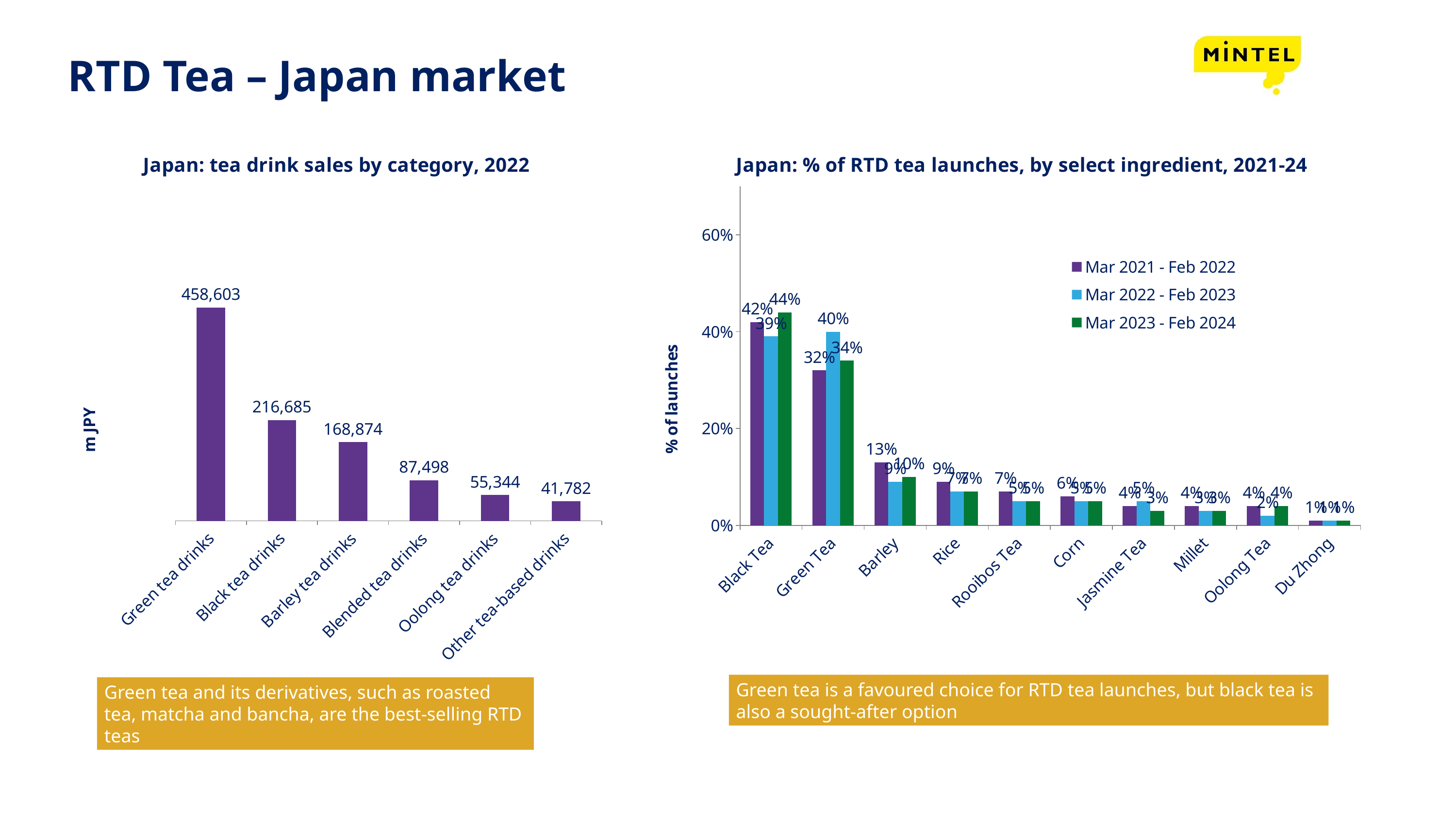
In the chart 'Japan: tea drink sales by category, 2022', what is the difference between Black tea drinks and Barley tea drinks? 47,811 In the chart 'Japan: % of RTD tea launches, by select ingredient, 2021-24', how many series does the legend list? 3 In the chart 'Japan: tea drink sales by category, 2022', what is the value for Oolong tea drinks? 55,344 In the chart 'Japan: % of RTD tea launches, by select ingredient, 2021-24', which is larger for Mar 2021 - Feb 2022: Black Tea or Green Tea? Black Tea In the chart 'Japan: % of RTD tea launches, by select ingredient, 2021-24', what is the value for Green Tea in Mar 2022 - Feb 2023? 40% In the chart 'Japan: % of RTD tea launches, by select ingredient, 2021-24', what is the value for Black Tea in Mar 2023 - Feb 2024? 44% In the chart 'Japan: tea drink sales by category, 2022', what is the value for Green tea drinks? 458,603 In the chart 'Japan: % of RTD tea launches, by select ingredient, 2021-24', which colour represents Mar 2023 - Feb 2024? Green In the chart 'Japan: % of RTD tea launches, by select ingredient, 2021-24', what is the value for Barley in Mar 2021 - Feb 2022? 13% What kind of chart is 'Japan: % of RTD tea launches, by select ingredient, 2021-24'? Bar chart In the chart 'Japan: tea drink sales by category, 2022', which category has the lowest sales? Other tea-based drinks In the chart 'Japan: tea drink sales by category, 2022', how many categories are shown? 6